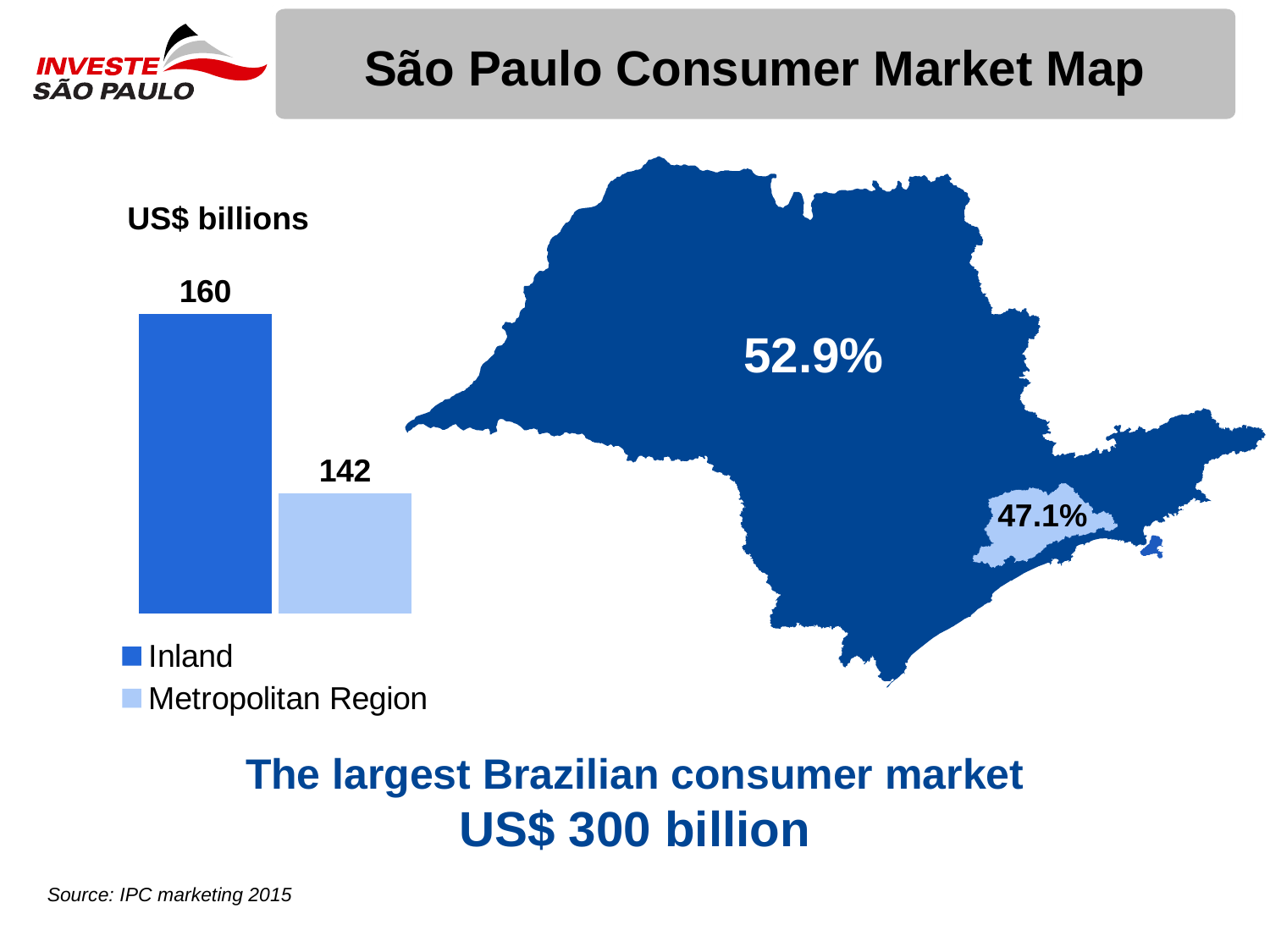
What is the difference between the Inland and Metropolitan Region values in the bar chart? 18 What percentage is shown on the Metropolitan Region area of the map? 47.1% Which series has the highest value in the bar chart? Inland Which is larger in the bar chart, Inland or Metropolitan Region? Inland What is the value for Metropolitan Region in the bar chart? 142 What is the value for Inland in the bar chart? 160 How many bars are plotted in the bar chart? 2 What kind of chart is shown on the left of the slide? Bar chart What unit is stated above the bar chart? US$ billions Which series has the lowest value in the bar chart? Metropolitan Region What is the total of the Inland and Metropolitan Region values in the bar chart? 302 How many series does the legend of the bar chart list? 2